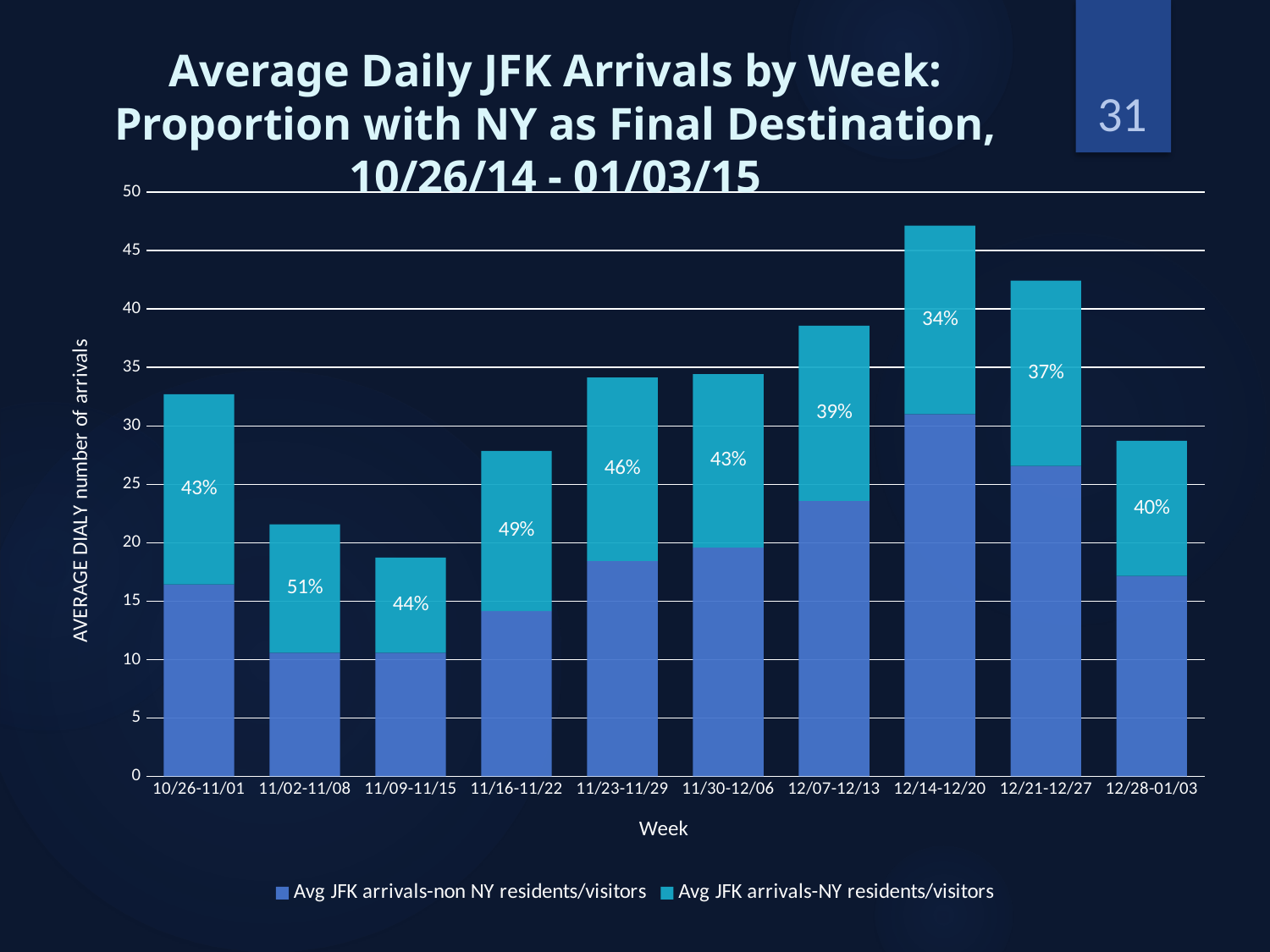
How many weeks are shown on the x axis? 10 What percentage label is shown on the bar for the week 11/02-11/08? 51% What percentage label is shown on the bar for the week 12/14-12/20? 34% What is the difference between the percentage labels for 11/02-11/08 and 12/14-12/20? 17 percentage points Which week has the larger percentage label, 11/16-11/22 or 12/07-12/13? 11/16-11/22 Is the total bar height for the week 11/09-11/15 greater or less than 20? less Is the total bar height for the week 12/14-12/20 greater or less than 45? greater What kind of chart is shown on the slide? Stacked bar chart Which week has the highest percentage label? 11/02-11/08 Which week has the lowest percentage label? 12/14-12/20 Which week has the tallest total bar? 12/14-12/20 How many series does the legend list? 2